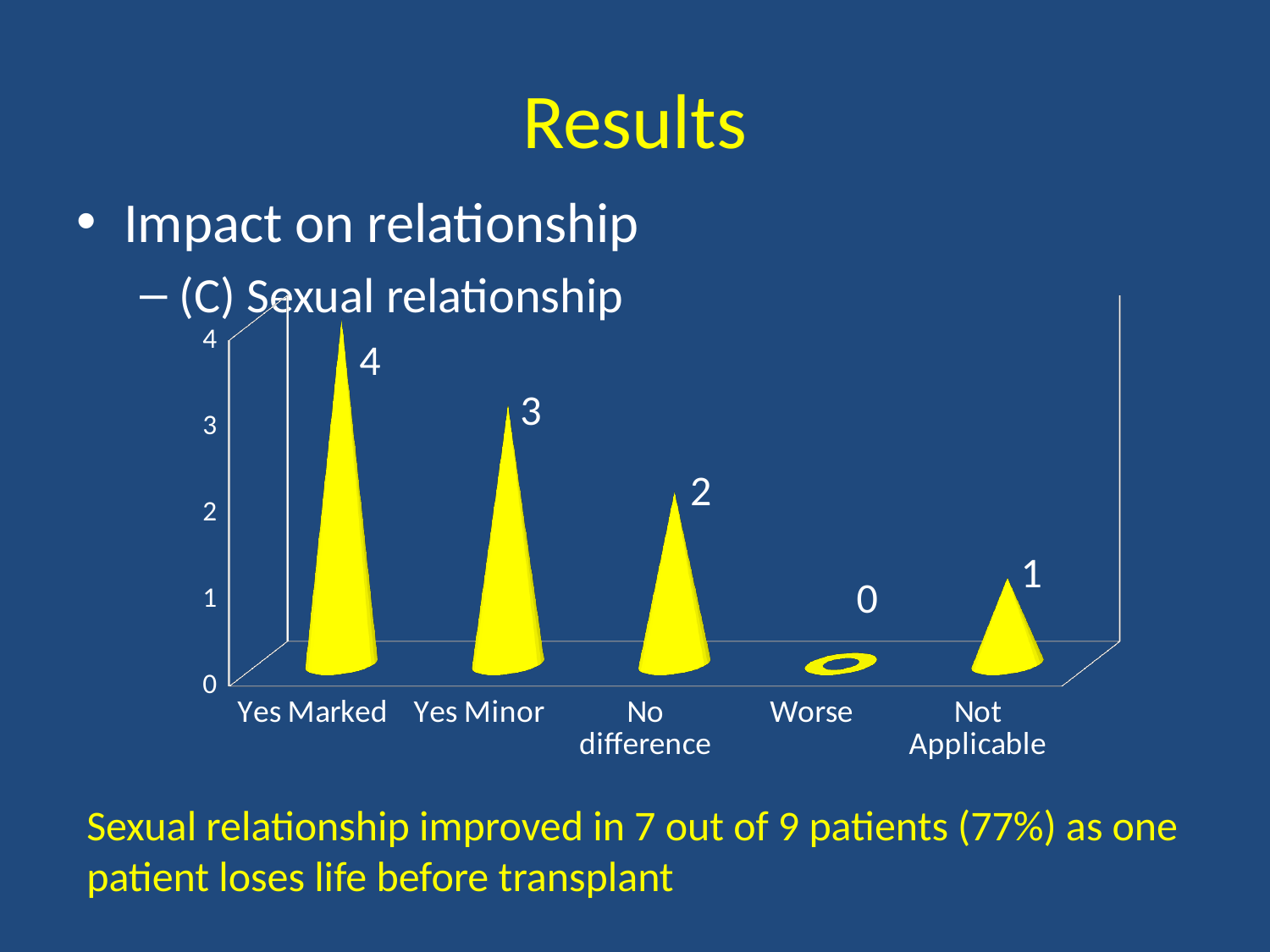
How many categories are shown on the x axis? 5 What kind of chart is shown on the slide? bar chart What is the value for No difference? 2 Which category has the lowest value? Worse Which category has the highest value? Yes Marked What is the value for Yes Marked? 4 Which is larger, the value for Yes Minor or the value for Not Applicable? Yes Minor What is the value for Yes Minor? 3 What is the value for Worse? 0 What is the difference between the values for Yes Marked and No difference? 2 What is the value for Not Applicable? 1 Do the values rise or fall from Yes Marked to No difference along the x axis? fall